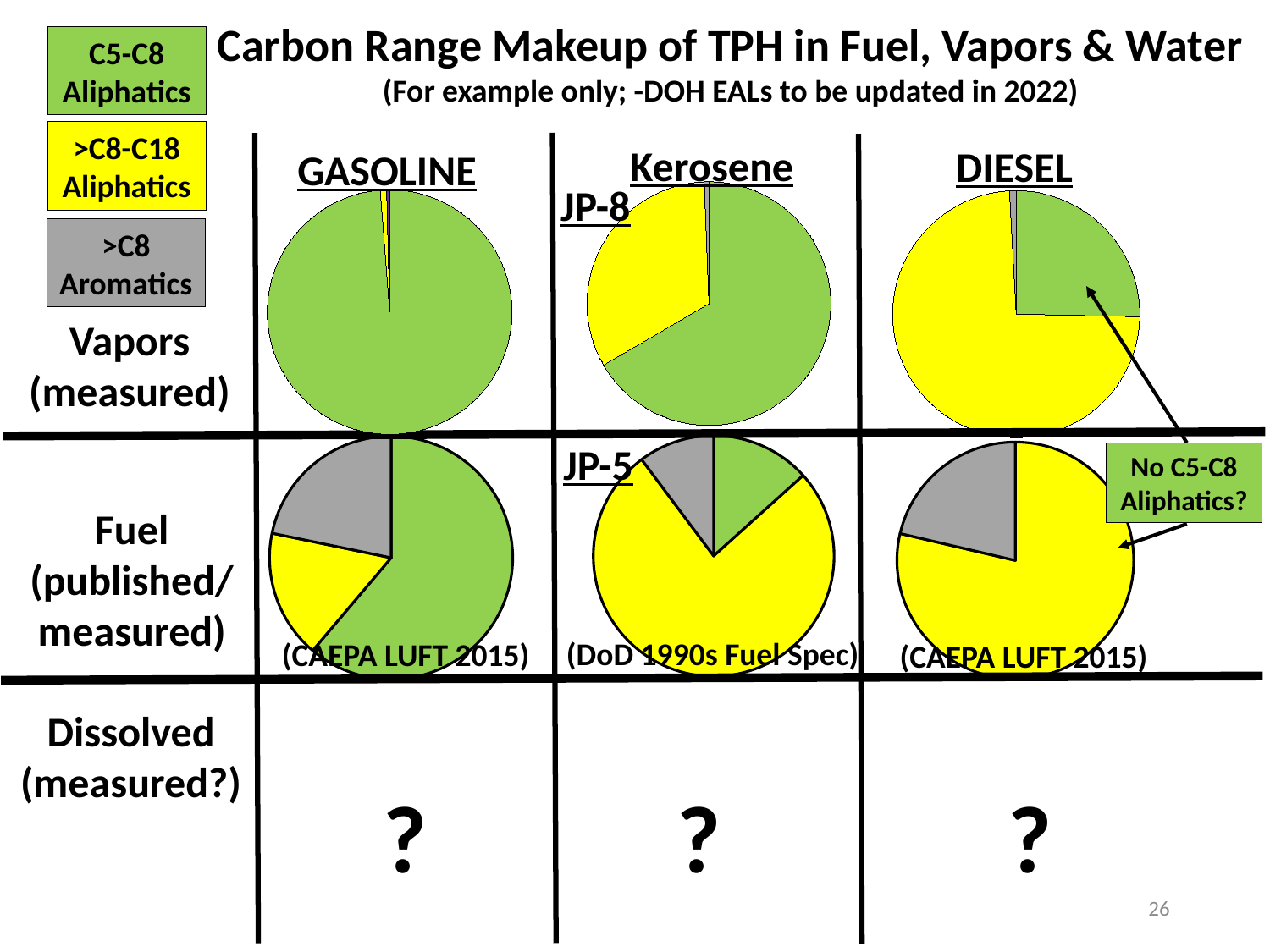
How many carbon range categories does the legend list? 3 How many slices does the DIESEL Fuel (published/measured) pie chart have? 2 In the JP-5 Fuel (published/measured) pie chart, which carbon range category has the largest share? >C8-C18 Aliphatics What kind of chart is used to show the carbon range makeup of each fuel on this slide? Pie chart In the Kerosene/JP-8 Vapors (measured) pie chart, which carbon range category has the largest share? C5-C8 Aliphatics In the GASOLINE Vapors (measured) pie chart, which carbon range category has the largest share? C5-C8 Aliphatics In the DIESEL Vapors (measured) pie chart, which is larger: the C5-C8 Aliphatics slice or the >C8-C18 Aliphatics slice? >C8-C18 Aliphatics In the Kerosene/JP-8 Vapors (measured) pie chart, which is larger: the C5-C8 Aliphatics slice or the >C8-C18 Aliphatics slice? C5-C8 Aliphatics Which colour represents >C8 Aromatics in the legend? Gray